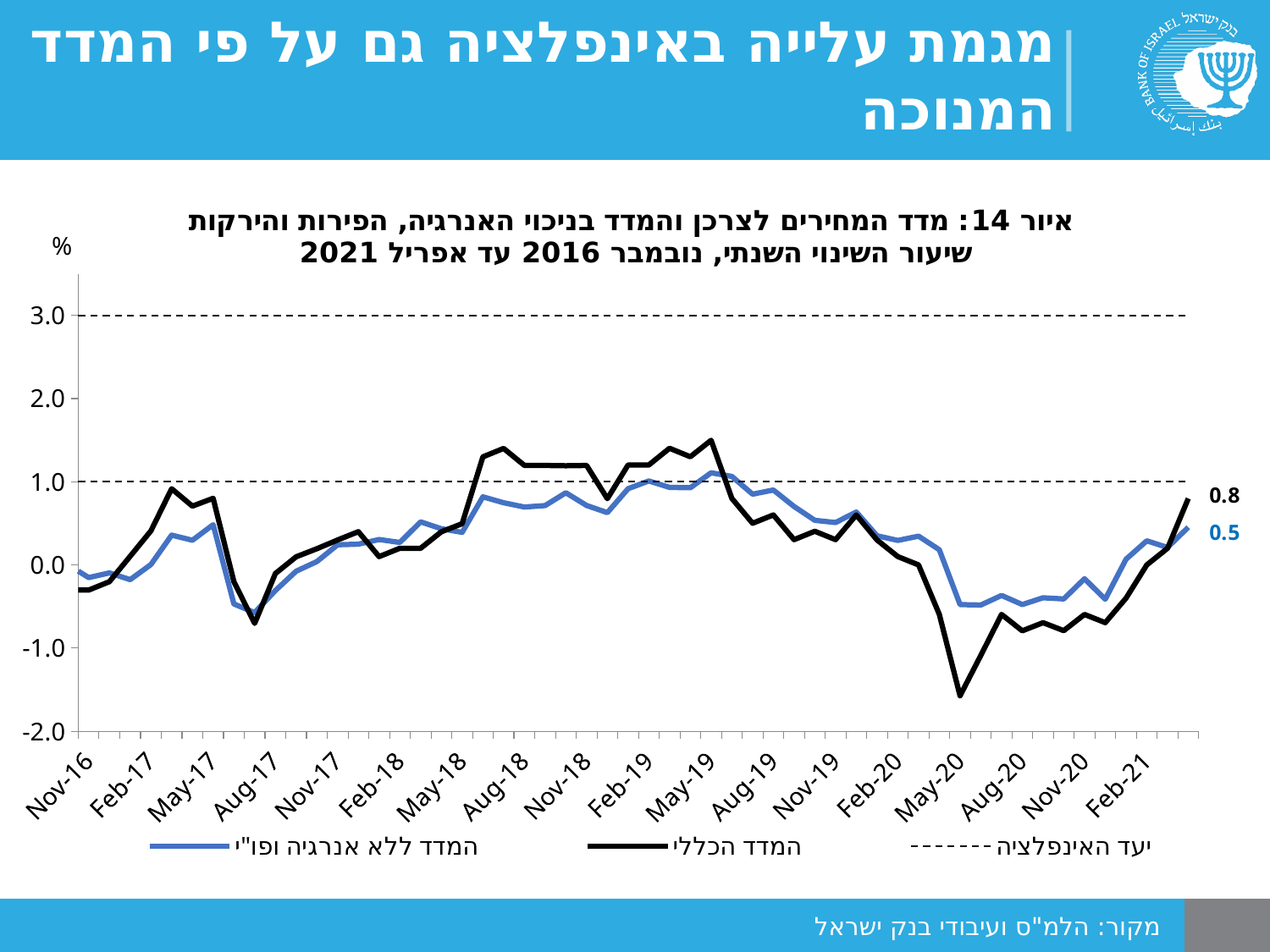
Is the value of the black line ("המדד הכללי") around May-20 greater or less than -1.0? less From Nov-20 to the end of the chart, do the two lines rise or fall? rise What is the latest value shown for the series "המדד ללא אנרגיה ופו"י" (the blue line) at the right end of the chart? 0.5 Is the value of the black line ("המדד הכללי") around Aug-18 greater or less than 1.0? greater At the right end of the chart, which series has the higher value: "המדד הכללי" or "המדד ללא אנרגיה ופו"י"? המדד הכללי Around May-20, which line is higher: the black line or the blue line? the blue line What is the difference between the final labelled values of the black line (0.8) and the blue line (0.5)? 0.3 How many entries does the chart legend list? 3 What kind of chart is shown on the slide? line chart What is the latest value shown for the series "המדד הכללי" (the black line) at the right end of the chart? 0.8 At which month does the black line ("המדד הכללי") reach its lowest point? May-20 Is the value of the blue line ("המדד ללא אנרגיה ופו"י") around May-20 greater or less than -1.0? greater